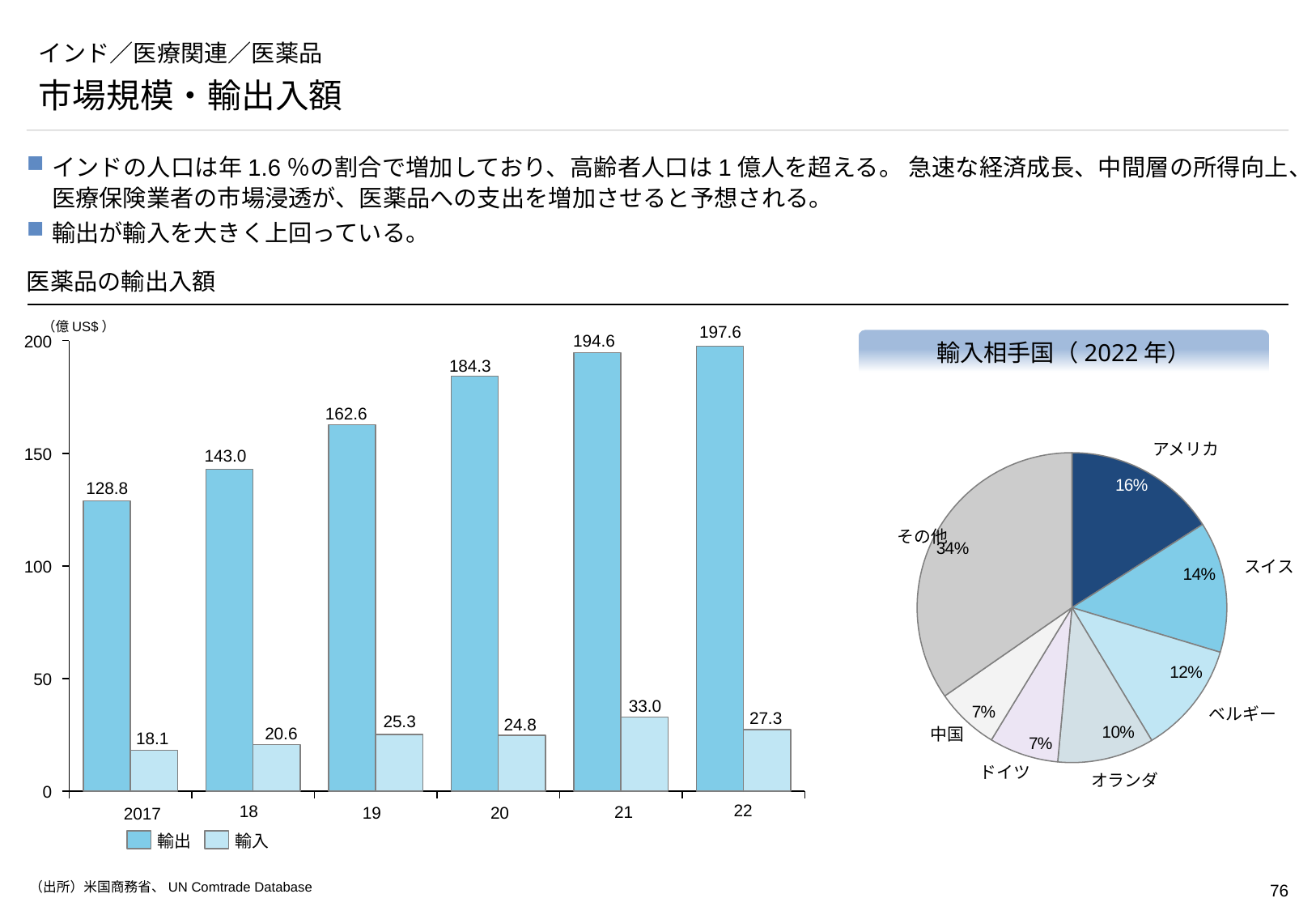
In the bar chart 医薬品の輸出入額, what is the 輸出 value for 2017? 128.8 In the bar chart 医薬品の輸出入額, how many series does the legend list? 2 In the bar chart 医薬品の輸出入額, how many years are shown on the x axis? 6 In the bar chart 医薬品の輸出入額, which year has the lowest 輸入 value? 2017 In the pie chart 輸入相手国（2022年）, which named country (excluding その他) has the largest share? アメリカ What kind of chart is the chart on the right of the slide? pie chart In the bar chart 医薬品の輸出入額, which year has the highest 輸出 value? 22 In the bar chart 医薬品の輸出入額, do the 輸出 values rise or fall from 2017 to 22? rise In the pie chart 輸入相手国（2022年）, what share does アメリカ have? 16% In the bar chart 医薬品の輸出入額, is the 輸入 value for 21 larger or smaller than the 輸入 value for 22? larger In the bar chart 医薬品の輸出入額, what is the 輸入 value for 21? 33.0 In the bar chart 医薬品の輸出入額, what is the difference between the 輸出 values for 22 and 21? 3.0